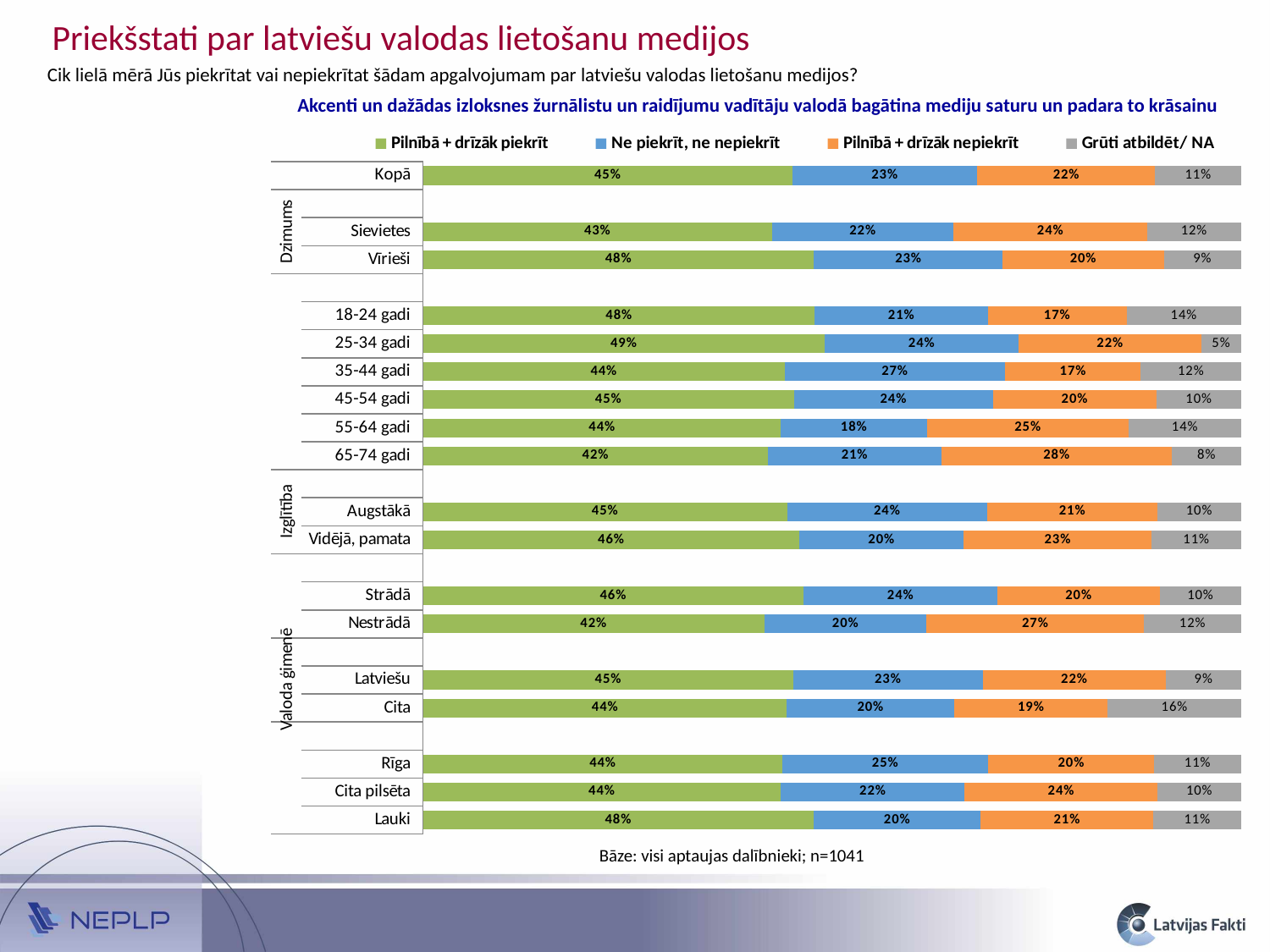
What is the value for Grūti atbildēt/ NA in the 25-34 gadi group? 5% Which group has the highest share of Pilnībā + drīzāk piekrīt? 25-34 gadi Which group has the highest share of Grūti atbildēt/ NA? Cita Which group has the highest share of Ne piekrīt, ne nepiekrīt? 35-44 gadi What is the difference in percentage points between Vīrieši and Sievietes for Pilnībā + drīzāk piekrīt? 5 percentage points What kind of chart is shown on the slide? Stacked bar chart What percentage of the 65-74 gadi group fully or rather disagrees (Pilnībā + drīzāk nepiekrīt)? 28% How many series does the legend list? 4 Which group has the lowest share of Grūti atbildēt/ NA? 25-34 gadi What is the Ne piekrīt, ne nepiekrīt value for the Nestrādā group? 20% What percentage of the Kopā group fully or rather agrees (Pilnībā + drīzāk piekrīt)? 45% Which group has a larger share of Pilnībā + drīzāk nepiekrīt, Nestrādā or Strādā? Nestrādā